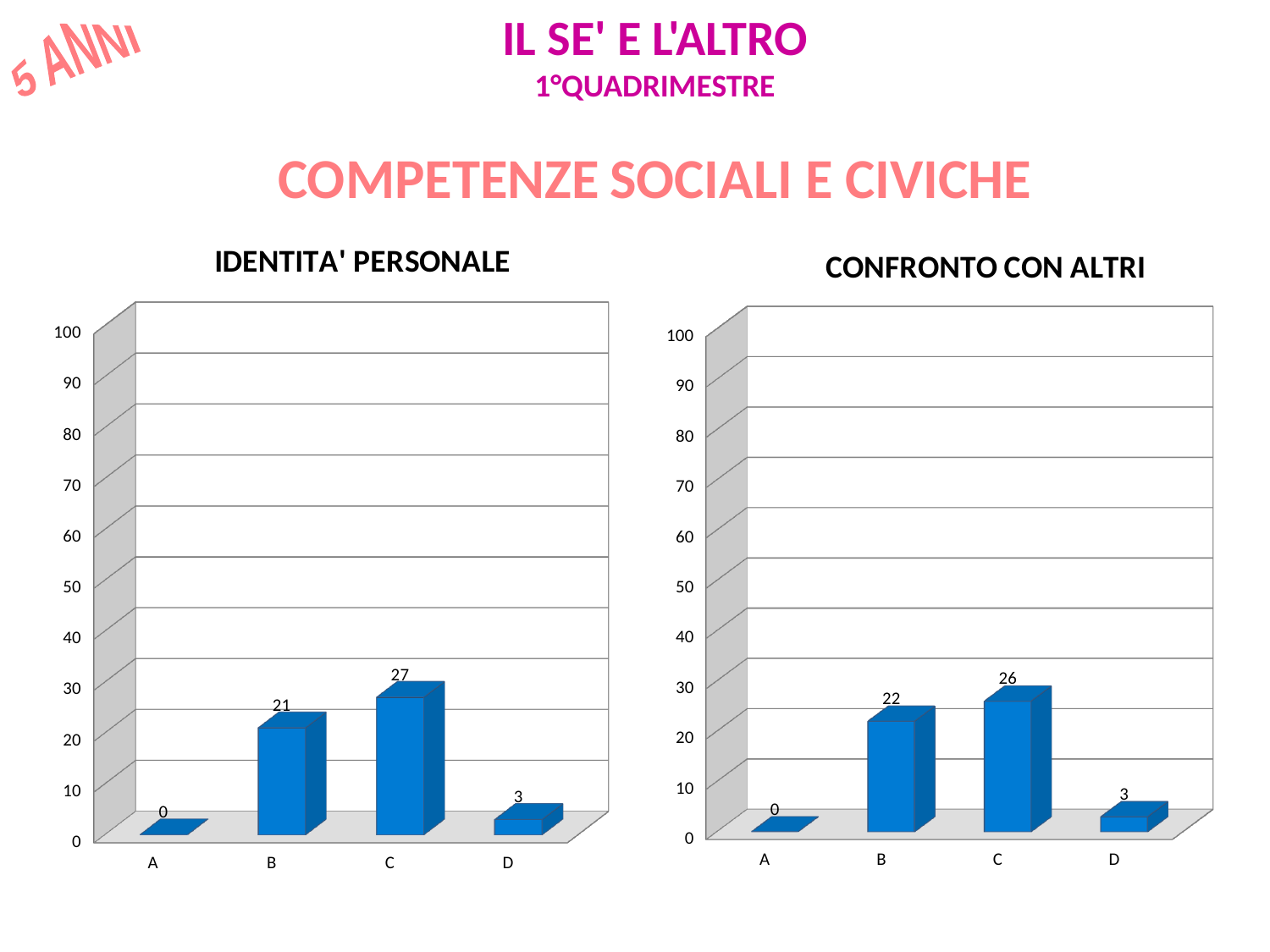
In the CONFRONTO CON ALTRI chart, what is the difference between the values for C and D? 23 In the IDENTITA' PERSONALE chart, what is the value for category C? 27 In the IDENTITA' PERSONALE chart, is the value for C greater or less than 30? less What kind of chart is the IDENTITA' PERSONALE chart? bar chart How many categories are shown in the CONFRONTO CON ALTRI chart? 4 In the IDENTITA' PERSONALE chart, which category has the highest value? C In the CONFRONTO CON ALTRI chart, which is larger, the value for B or the value for C? C In the IDENTITA' PERSONALE chart, what is the value for category B? 21 In the CONFRONTO CON ALTRI chart, which category has the lowest value? A In the CONFRONTO CON ALTRI chart, what is the value for category D? 3 In the IDENTITA' PERSONALE chart, what is the difference between the values for C and B? 6 In the CONFRONTO CON ALTRI chart, what is the value for category B? 22